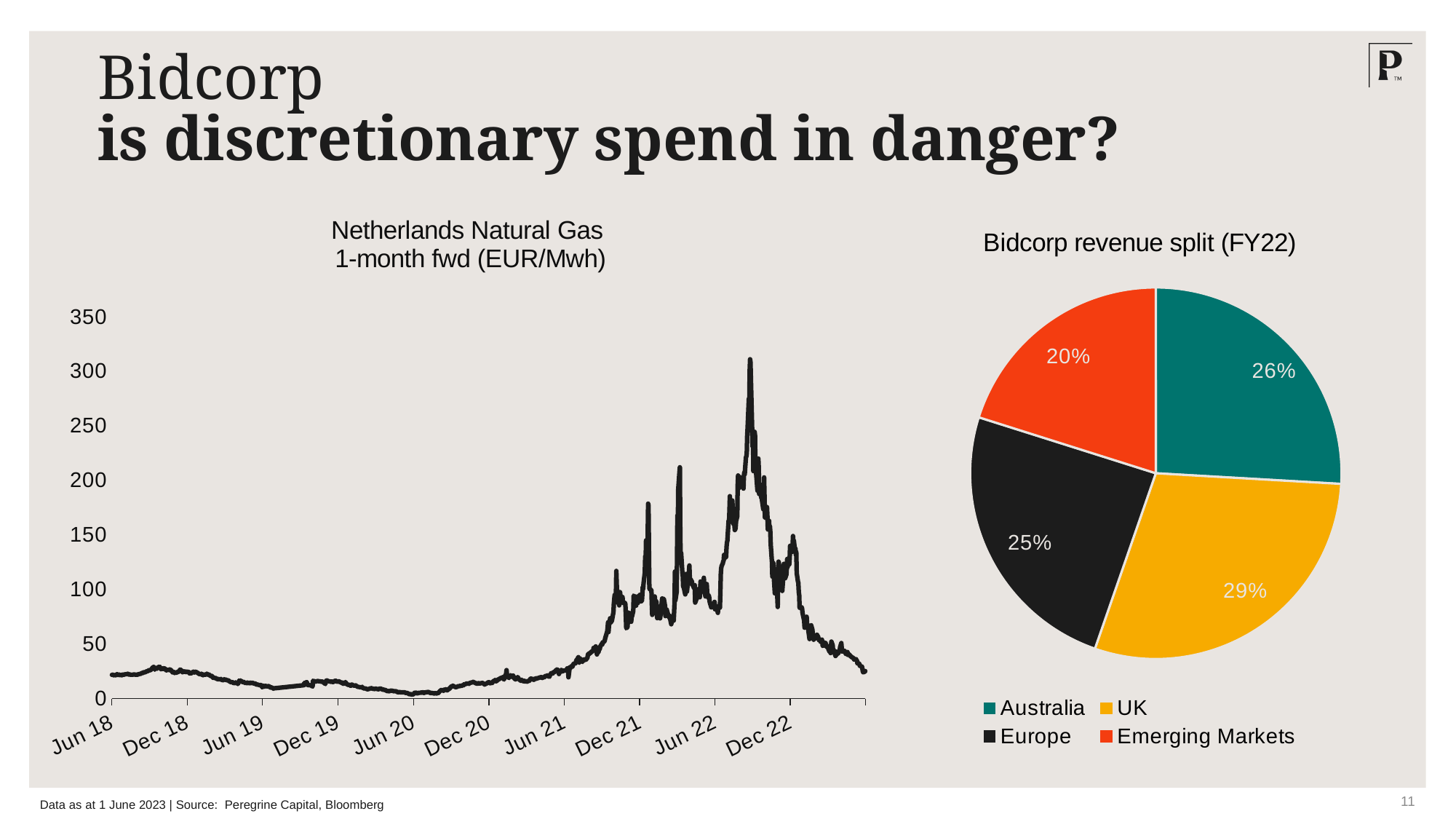
In the Bidcorp revenue split (FY22) pie chart, which region has the largest share of revenue? UK In the Bidcorp revenue split (FY22) pie chart, which region has the smallest share of revenue? Emerging Markets In the Netherlands Natural Gas 1-month fwd chart, is the value at Jun 20 greater or less than 50? less In the Netherlands Natural Gas 1-month fwd chart, is the peak value reached between Jun 22 and Dec 22 greater or less than 250? greater In the Bidcorp revenue split (FY22) pie chart, what share of revenue comes from Australia? 26% What kind of chart is the Netherlands Natural Gas 1-month fwd chart? Line chart How many regions does the legend of the Bidcorp revenue split (FY22) pie chart list? 4 In the Bidcorp revenue split (FY22) pie chart, what share of revenue comes from Emerging Markets? 20% In the Bidcorp revenue split (FY22) pie chart, which is larger, the Australia share or the Europe share? Australia In the Bidcorp revenue split (FY22) pie chart, what share of revenue comes from the UK? 29% In the Bidcorp revenue split (FY22) pie chart, what colour is the Europe slice? Black In the Bidcorp revenue split (FY22) pie chart, what is the difference in percentage points between the UK share and the Europe share? 4 percentage points